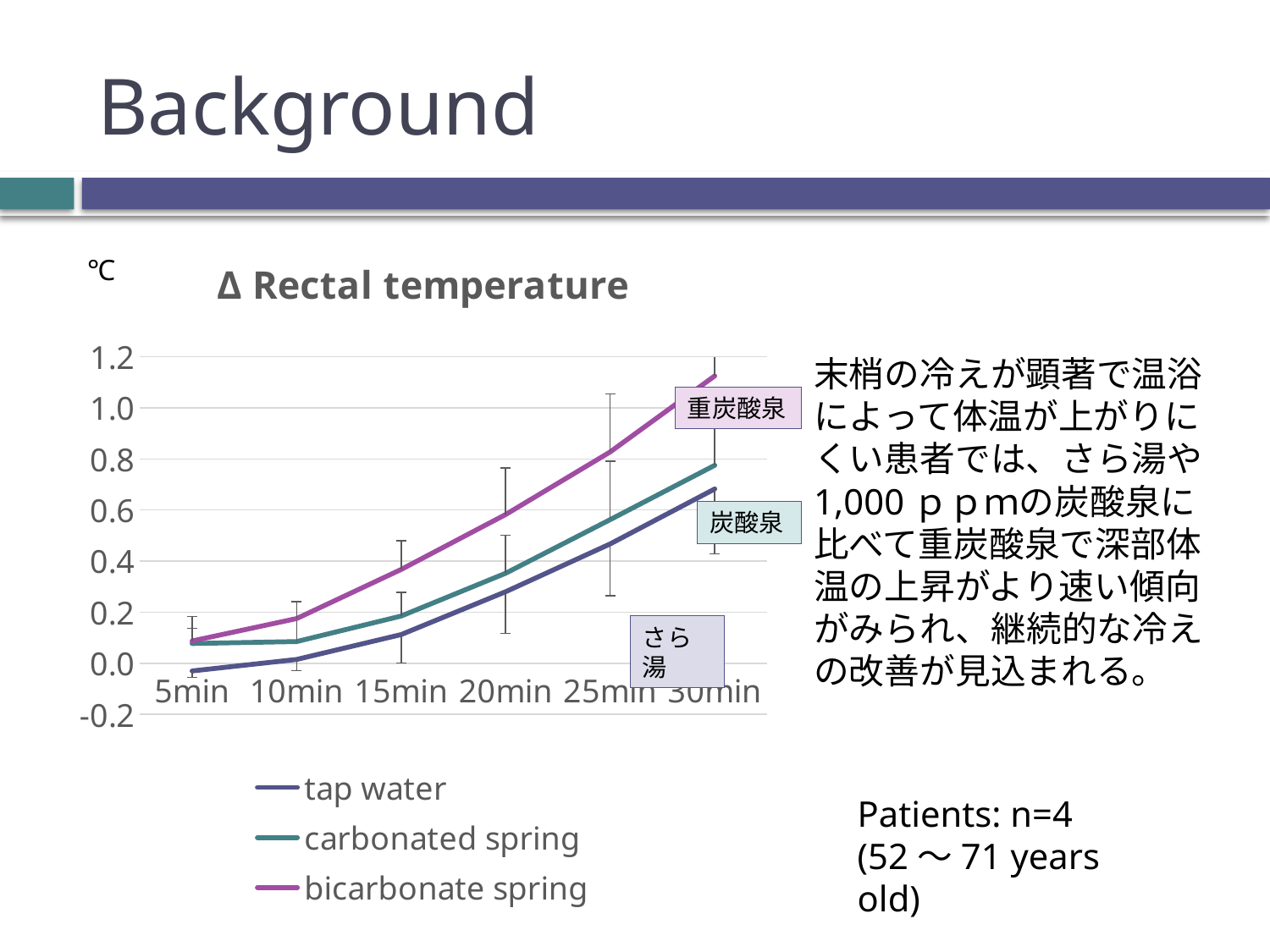
Which series has the highest value at 30min? bicarbonate spring Is the value for bicarbonate spring at 20min greater or less than 0.4? greater What kind of chart is shown on the slide? line chart What is the title of the chart? Δ Rectal temperature What unit is shown for the y axis of the chart? ℃ At 25min, which is larger: the value for bicarbonate spring or the value for tap water? bicarbonate spring How many series does the legend list? 3 Is the value for tap water at 20min greater or less than 0.4? less Do the values for bicarbonate spring rise or fall from 5min to 30min? rise Which series has the lowest value at 30min? tap water Is the value for bicarbonate spring at 30min greater or less than 1.0? greater How many time points are plotted along the x axis? 6